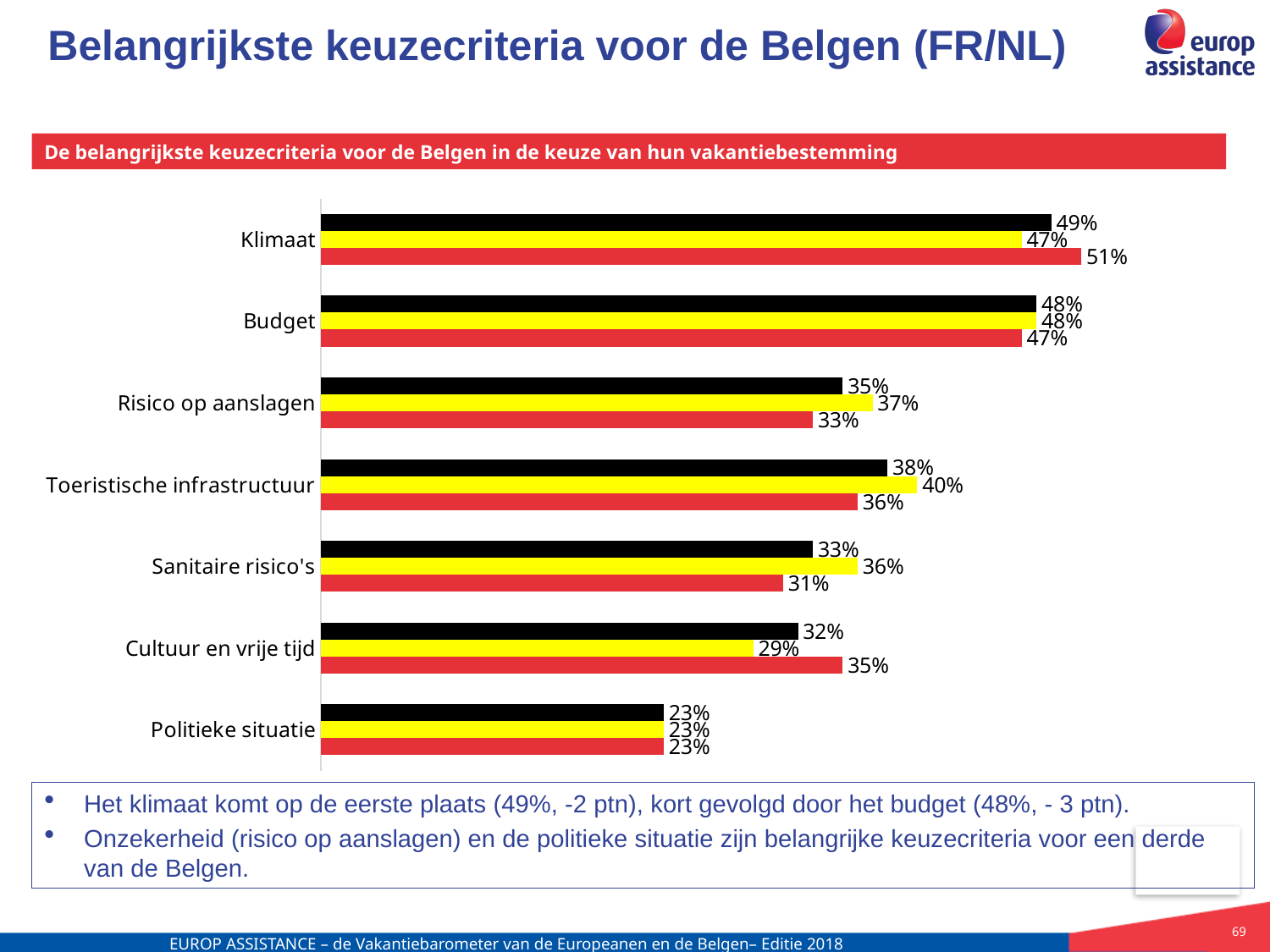
How many bars are shown for each category? 3 Which category has the lowest values across all three bars? Politieke situatie What is the value of the red bar for Cultuur en vrije tijd? 35% What is the difference between the red bar for Klimaat (51%) and the red bar for Budget (47%)? 4% Which category has the highest value for the black bar? Klimaat What is the title shown in the red banner above the chart? De belangrijkste keuzecriteria voor de Belgen in de keuze van hun vakantiebestemming How many categories are shown on the chart? 7 What is the value of the red bar for Klimaat? 51% What is the value of the yellow bar for Toeristische infrastructuur? 40% Which is larger for Sanitaire risico's: the yellow bar or the red bar? the yellow bar What is the value of the black bar for Klimaat? 49% What type of chart is shown on the slide? bar chart